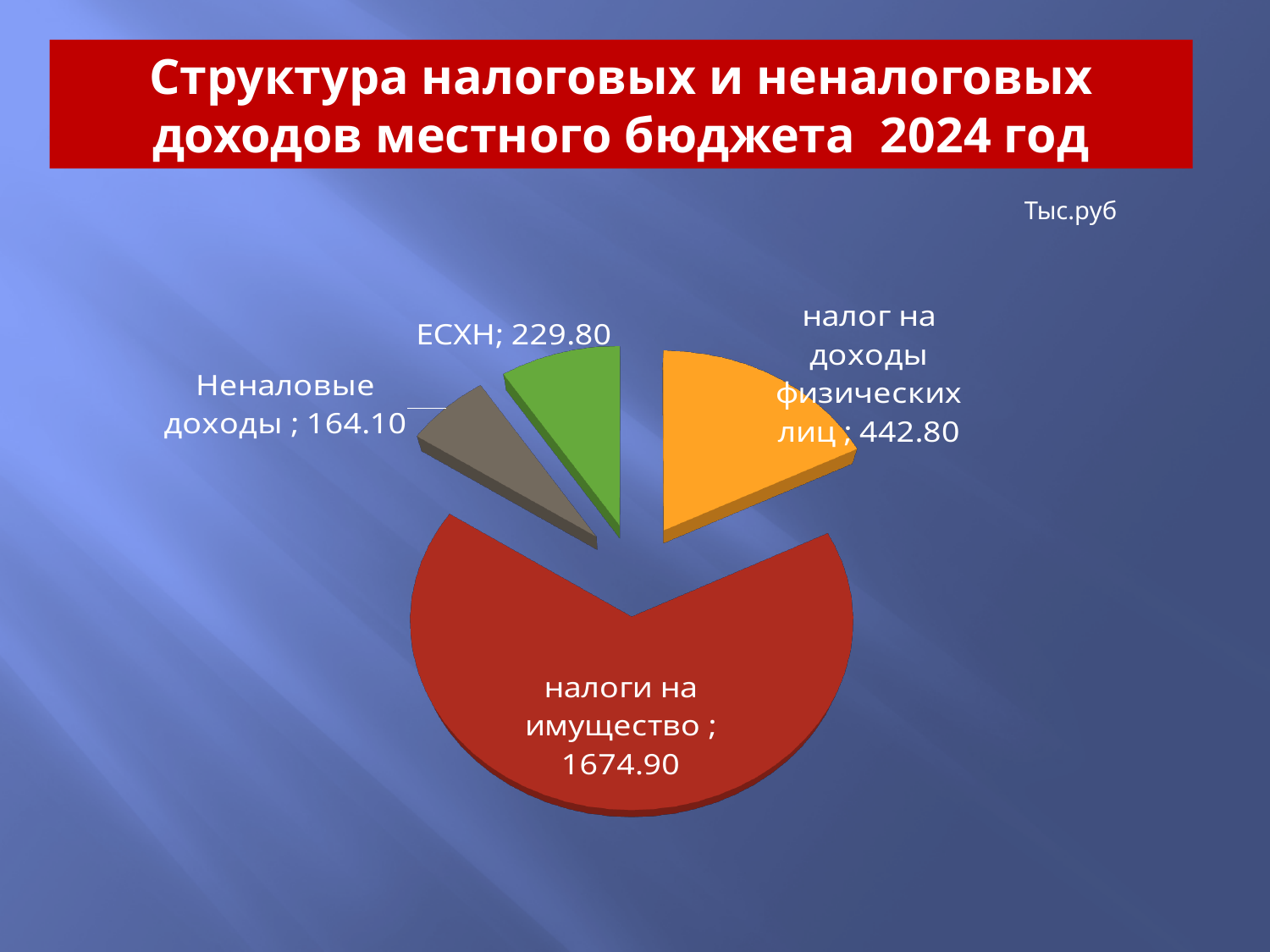
How many slices does the pie chart have? 4 Which category has the largest slice of the pie? налоги на имущество What is the difference between налоги на имущество and налог на доходы физических лиц? 1232.10 What is the value for ЕСХН? 229.80 What is the total of all slices in the pie chart? 2511.60 Which is larger, ЕСХН or Неналовые доходы? ЕСХН What kind of chart is shown on the slide? Pie chart What unit is stated for the values on the slide? Тыс.руб What is the value for налог на доходы физических лиц? 442.80 Which category has the smallest slice of the pie? Неналовые доходы What is the value for Неналовые доходы? 164.10 What is the value for налоги на имущество? 1674.90